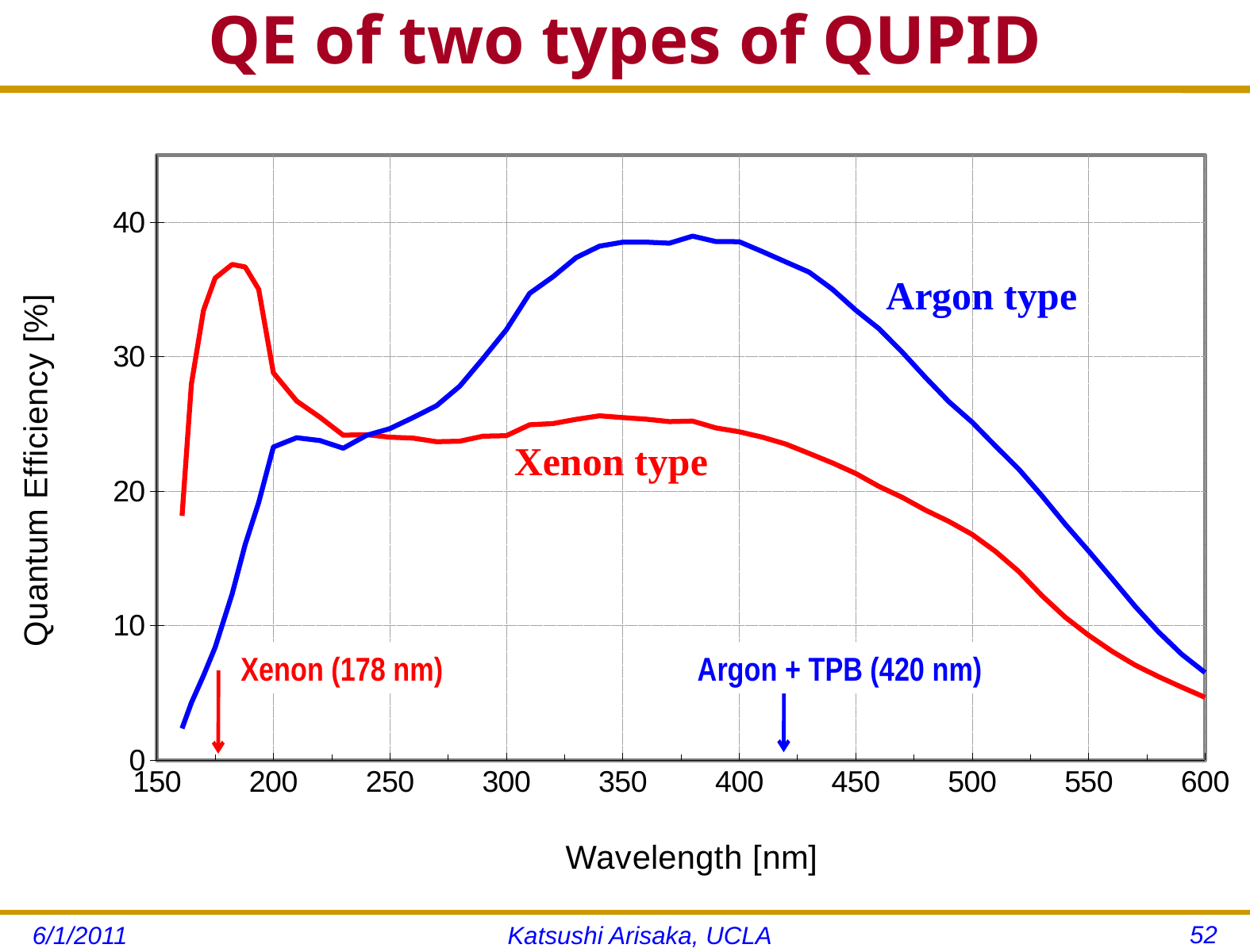
Is the quantum efficiency of the Argon type at 200 nm greater or less than 20? greater Does the Argon type curve rise or fall between 450 nm and 600 nm? fall What wavelength is marked by the blue arrow labelled Argon + TPB? 420 nm At 180 nm, which type has the higher quantum efficiency, Argon type or Xenon type? Xenon type How many series (curves) are plotted on the chart? 2 Is the quantum efficiency of the Xenon type at 500 nm greater or less than 20? less At 400 nm, which type has the higher quantum efficiency, Argon type or Xenon type? Argon type What is the label of the x axis? Wavelength [nm] Is the quantum efficiency of the Argon type at 400 nm greater or less than 30? greater What kind of chart is shown on the slide? line chart